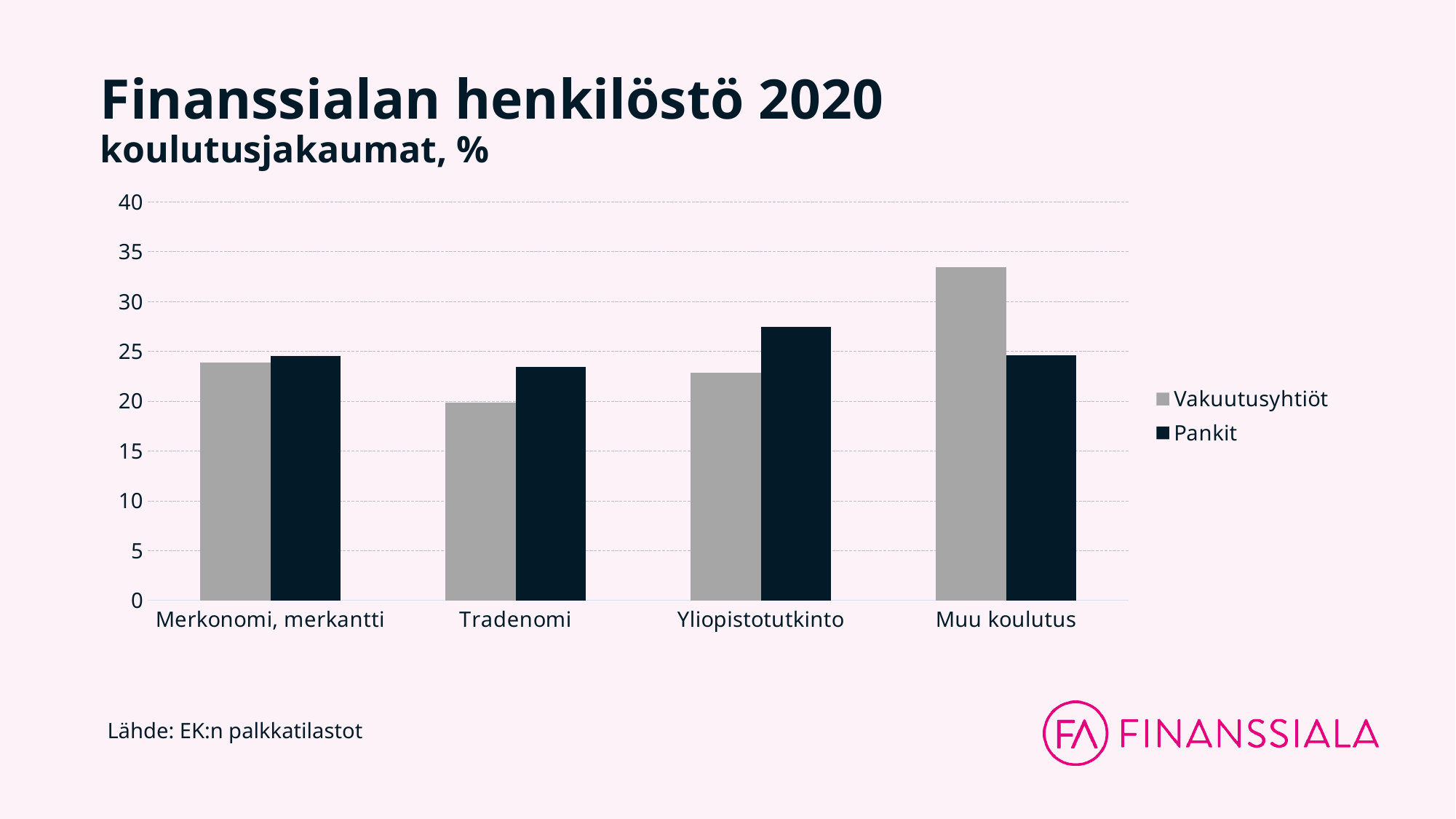
Is the value for Vakuutusyhtiöt in Tradenomi greater or less than 25? less Which category has the highest value for Pankit? Yliopistotutkinto What kind of chart is shown on the slide? bar chart For Yliopistotutkinto, which series has the larger value, Vakuutusyhtiöt or Pankit? Pankit For Muu koulutus, which series has the larger value, Vakuutusyhtiöt or Pankit? Vakuutusyhtiöt Is the value for Vakuutusyhtiöt in Muu koulutus greater or less than 30? greater Is the value for Pankit in Yliopistotutkinto greater or less than 25? greater How many education categories are shown on the x axis? 4 Which category has the lowest value for Vakuutusyhtiöt? Tradenomi How many series does the legend list? 2 Which category has the highest value for Vakuutusyhtiöt? Muu koulutus What is the title of the chart? Finanssialan henkilöstö 2020 koulutusjakaumat, %